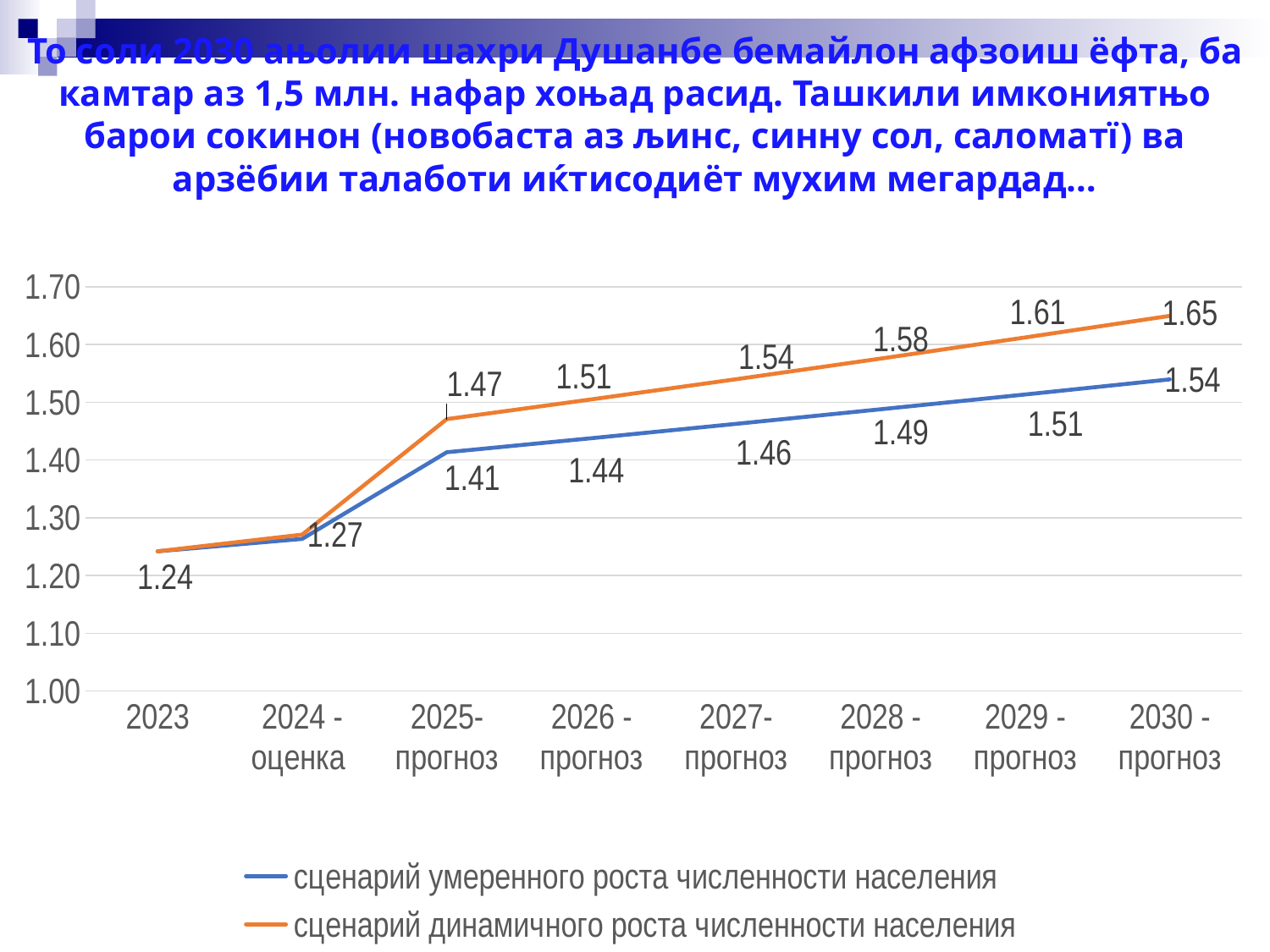
What is the value of the 'сценарий умеренного роста численности населения' series for 2027- прогноз? 1.46 Which series has the larger value for 2028 - прогноз? сценарий динамичного роста численности населения What is the value of the 'сценарий динамичного роста численности населения' series for 2030 - прогноз? 1.65 What is the difference between the two series' values for 2030 - прогноз? 0.11 What is the value of the 'сценарий динамичного роста численности населения' series for 2025-прогноз? 1.47 How many series does the legend list? 2 What kind of chart is shown on the slide? line chart Do the values of the 'сценарий динамичного роста численности населения' series rise or fall from 2023 to 2030 - прогноз? rise What is the value for 2023? 1.24 In which category does the 'сценарий умеренного роста численности населения' series reach its highest value? 2030 - прогноз In which category is the value lowest? 2023 How many categories are shown on the x axis? 8